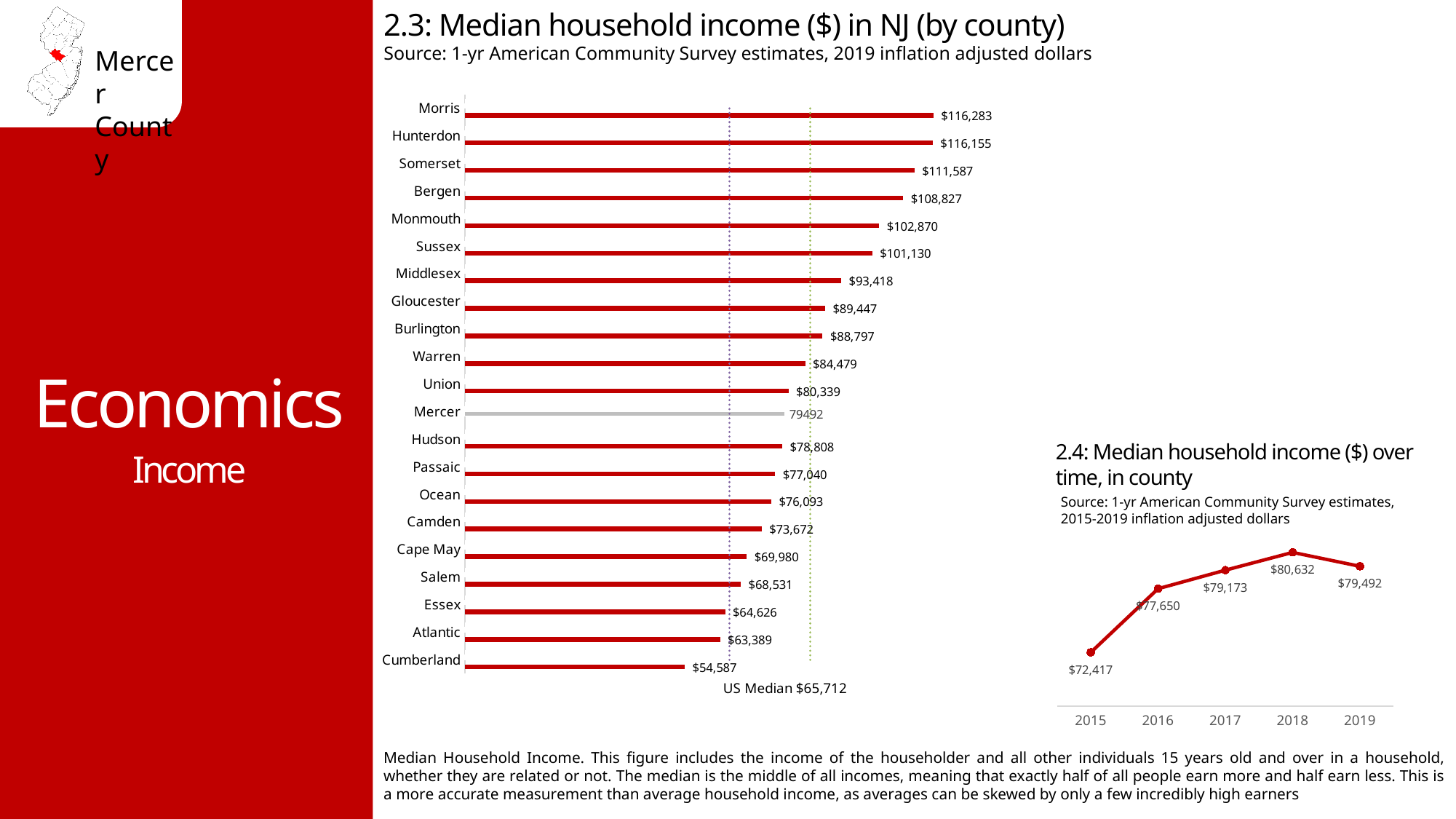
In chart 2.4 (Median household income over time, in county), which year had the highest median household income? 2018 In chart 2.3 (Median household income in NJ by county), which county has the highest median household income? Morris In chart 2.3 (Median household income in NJ by county), what is the median household income for Mercer? 79492 In chart 2.3 (Median household income in NJ by county), what is the median household income for Somerset? $111,587 In chart 2.3 (Median household income in NJ by county), which has a higher median household income, Gloucester or Camden? Gloucester In chart 2.3 (Median household income in NJ by county), what US Median value is noted on the chart? $65,712 In chart 2.3 (Median household income in NJ by county), what is the difference between the median household income of Bergen and Essex? $44,201 In chart 2.3 (Median household income in NJ by county), which county has the lowest median household income? Cumberland In chart 2.3 (Median household income in NJ by county), how many counties are shown? 21 In chart 2.4 (Median household income over time, in county), what was the median household income in 2016? $77,650 In chart 2.4 (Median household income over time, in county), what is the difference between the 2019 and 2015 values? $7,075 What type of chart is chart 2.3 (Median household income in NJ by county)? Bar chart